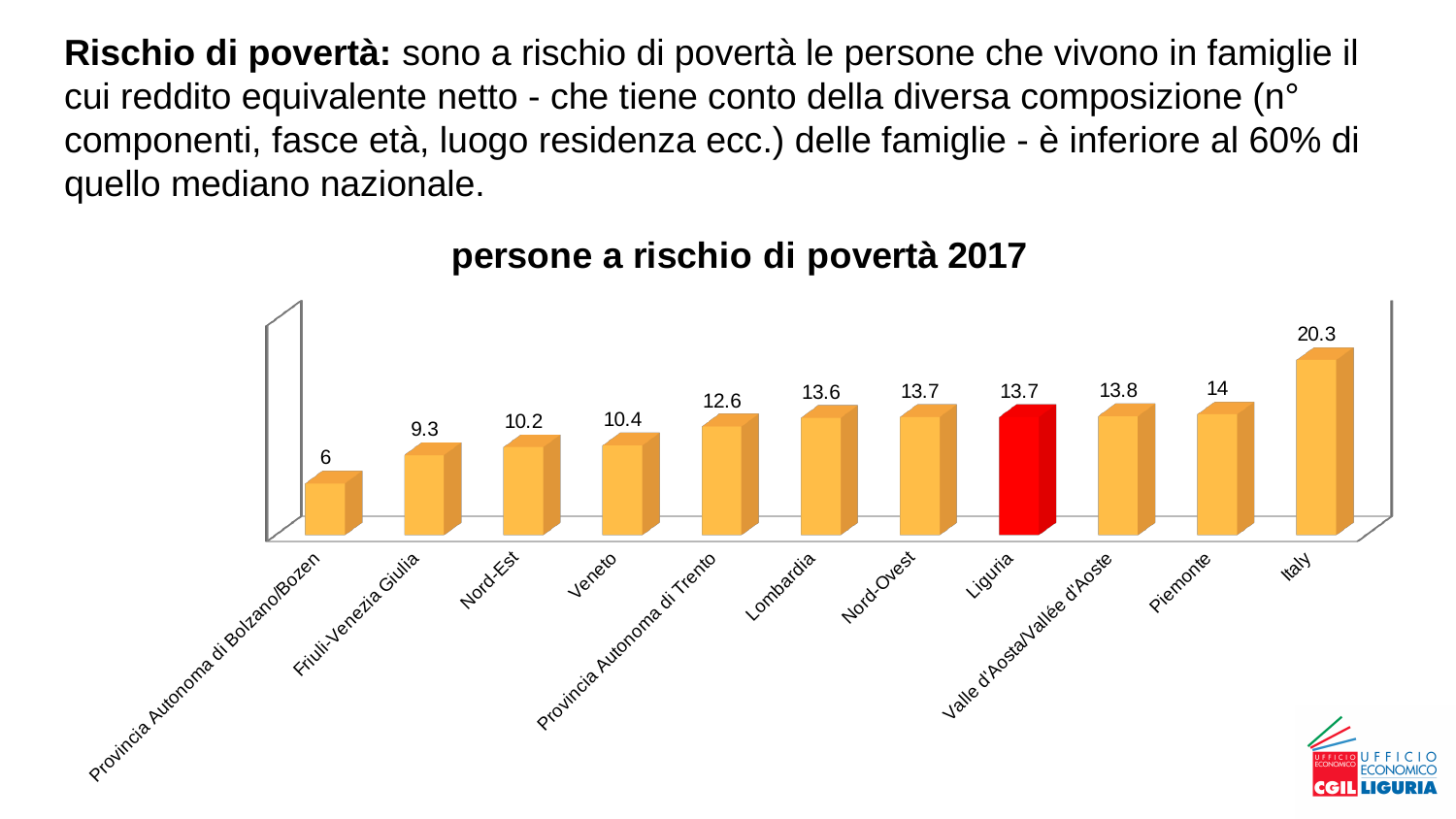
Which category has the highest value in the chart? Italy Which category has the lowest value in the chart? Provincia Autonoma di Bolzano/Bozen Which is larger, the value for Lombardia or the value for Provincia Autonoma di Trento? Lombardia What kind of chart is shown on the slide? Bar chart What is the value for Liguria in the chart 'persone a rischio di povertà 2017'? 13.7 What is the value for Italy in the chart? 20.3 What is the value for Provincia Autonoma di Bolzano/Bozen? 6 What is the difference between the values for Veneto and Nord-Est? 0.2 What is the difference between the values for Italy and Liguria? 6.6 Which bar in the chart is coloured red rather than orange? Liguria How many categories are shown in the chart? 11 What is the value for Piemonte? 14